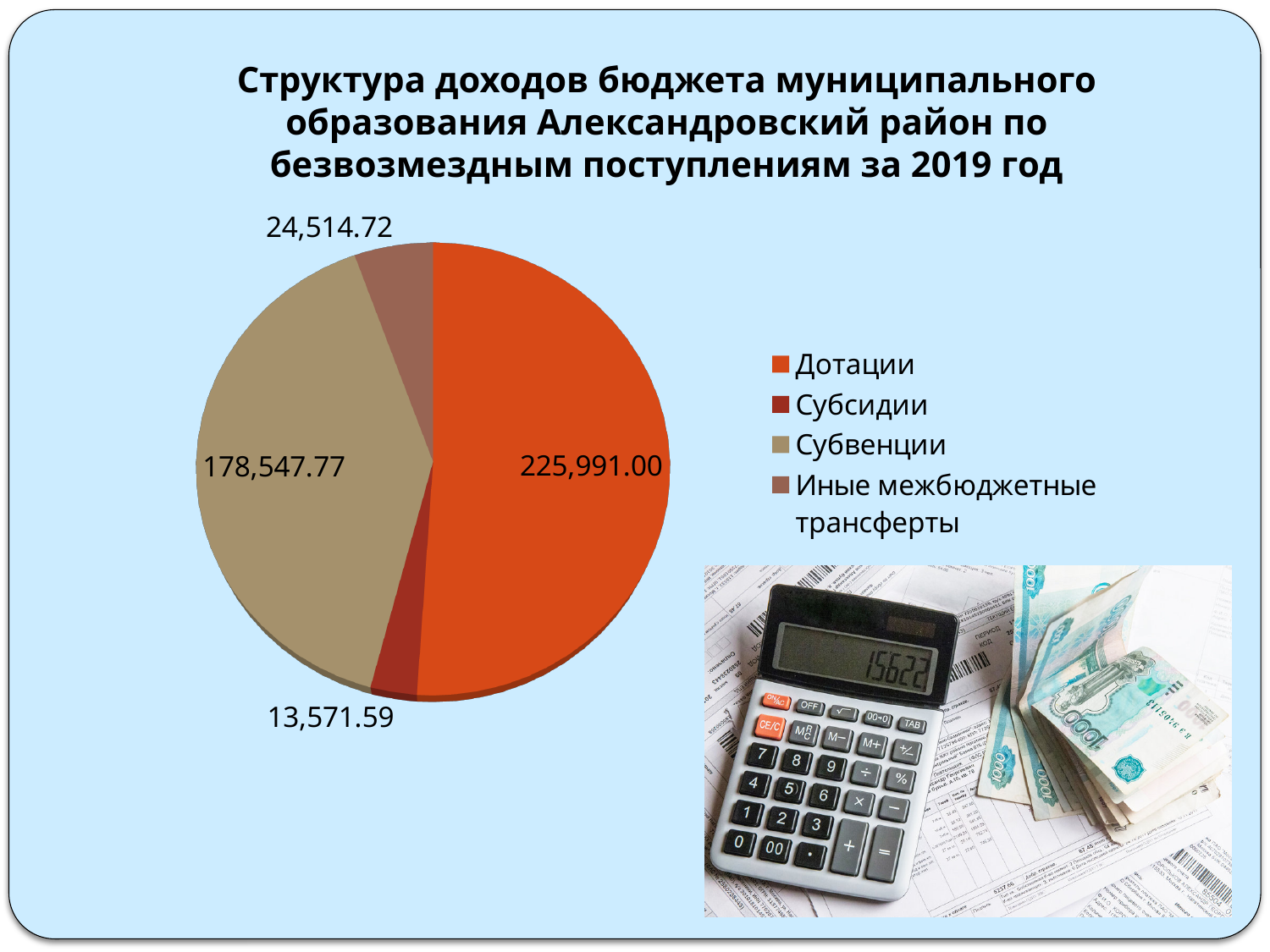
Which category has the largest slice of the pie? Дотации What is the value for Субвенции? 178,547.77 What is the difference between the values for Иные межбюджетные трансферты and Субсидии? 10,943.13 What is the difference between the values for Дотации and Субвенции? 47,443.23 What is the value for Субсидии? 13,571.59 Which is larger, Субвенции or Иные межбюджетные трансферты? Субвенции Which legend entry is shown in orange? Дотации What is the value for Иные межбюджетные трансферты? 24,514.72 What is the value for Дотации? 225,991.00 What kind of chart is shown on the slide? Pie chart How many slices does the pie chart have? 4 Which category has the smallest slice of the pie? Субсидии